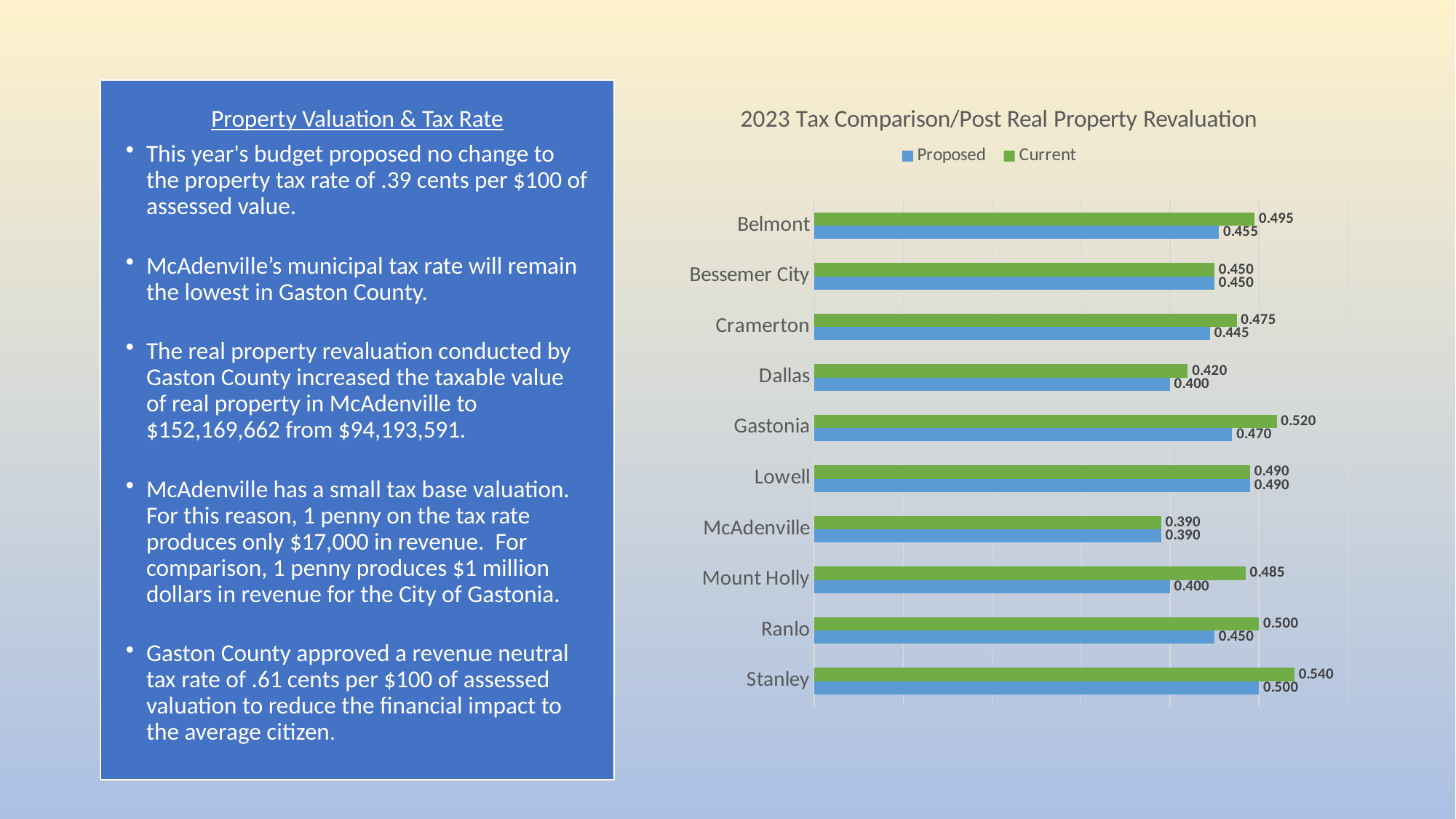
Which colour represents the Current series in the chart? Green Which municipality has the lowest Proposed tax rate? McAdenville What is the difference between the Current and Proposed tax rates for Stanley? 0.040 How many municipalities are shown in the chart? 10 What is the Proposed tax rate for Mount Holly? 0.400 What is the title of the chart? 2023 Tax Comparison/Post Real Property Revaluation What is the Current tax rate for Gastonia? 0.520 What is the difference between the Current and Proposed tax rates for Mount Holly? 0.085 Which is larger, the Proposed rate for Belmont or the Proposed rate for Gastonia? Gastonia What kind of chart is shown on the slide? Bar chart How many series does the legend list? 2 Which municipality has the highest Current tax rate? Stanley